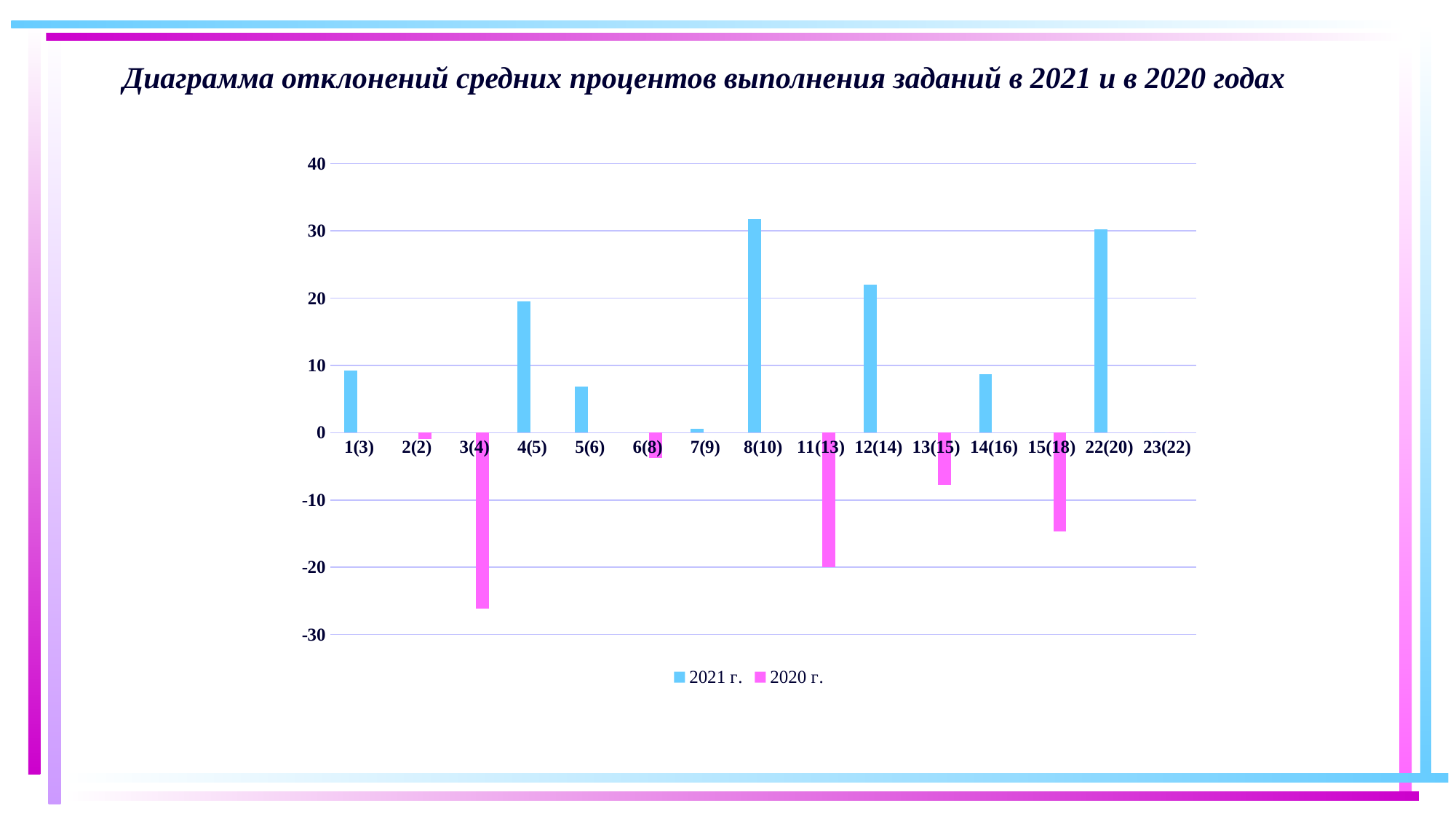
What is the title of the chart? Диаграмма отклонений средних процентов выполнения заданий в 2021 и в 2020 годах How many categories are shown on the x axis? 15 Which is larger, the value for 1(3) or the value for 22(20)? 22(20) Which is larger, the value for 4(5) or the value for 12(14)? 12(14) Is the value for 3(4) greater or less than -20? less Is the value for 12(14) greater or less than 20? greater How many series does the legend list? 2 Which series is shown in pink? 2020 г. What kind of chart is shown on the slide? bar chart Which category has the lowest value? 3(4) Is the value for 15(18) greater or less than -10? less